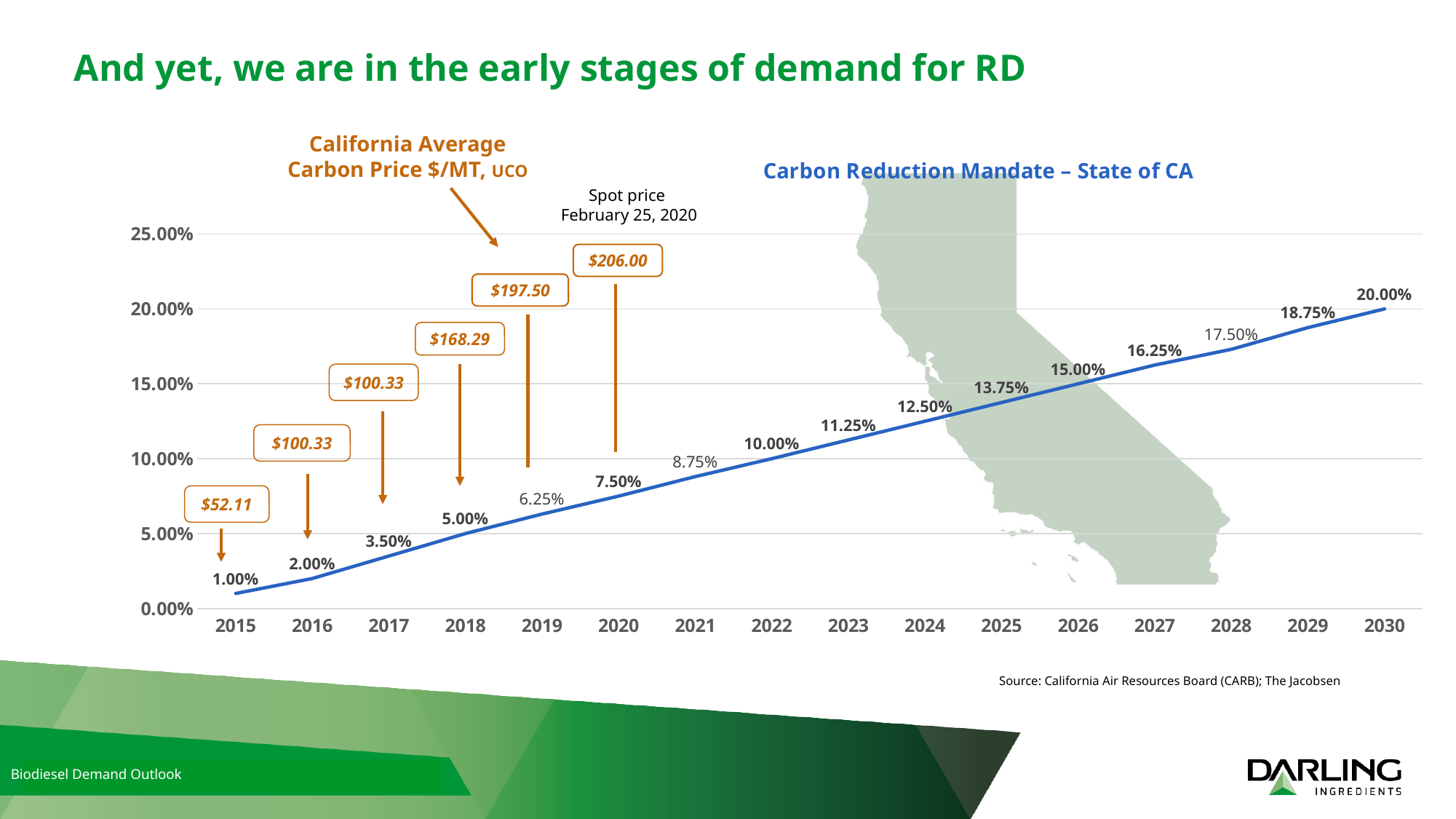
What is the Carbon Reduction Mandate value for 2015? 1.00% Does the Carbon Reduction Mandate rise or fall from 2015 to 2030? Rise What California Average Carbon Price is annotated for 2020 (spot price February 25, 2020)? $206.00 Which is larger, the Carbon Reduction Mandate value for 2022 or for 2018? 2022 What is the Carbon Reduction Mandate value for 2020? 7.50% Which year has the lowest Carbon Reduction Mandate value? 2015 What kind of chart is used to show the Carbon Reduction Mandate? Line chart How many years are shown on the x axis of the chart? 16 What is the Carbon Reduction Mandate value for 2030? 20.00% What is the Carbon Reduction Mandate value for 2025? 13.75% What is the difference between the Carbon Reduction Mandate values for 2030 and 2020? 12.50% Which year has the highest Carbon Reduction Mandate value? 2030